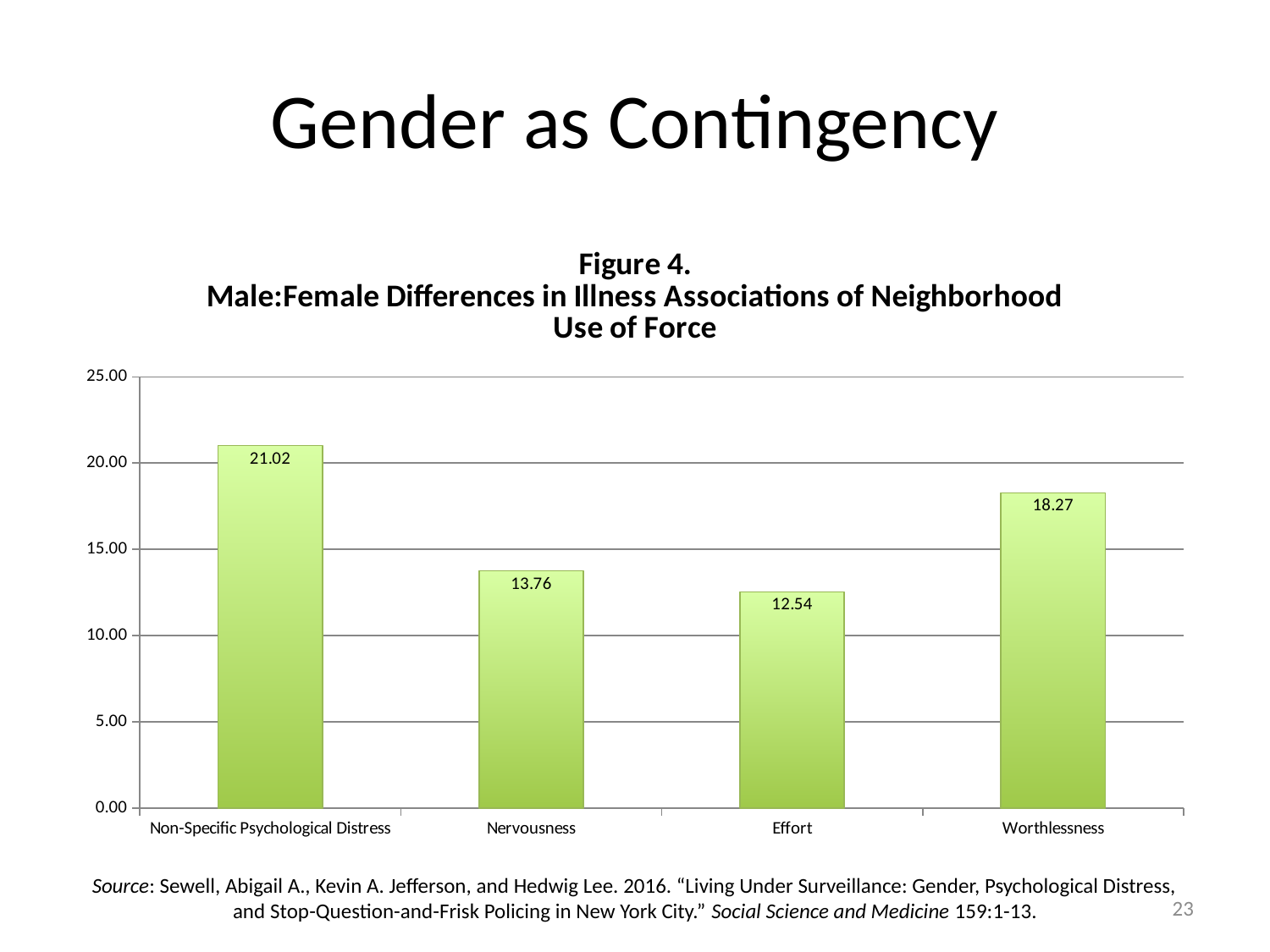
What is the difference between the values for Nervousness and Effort? 1.22 What is the difference between the values for Non-Specific Psychological Distress and Worthlessness? 2.75 How many categories are shown on the x axis? 4 Which is larger, the value for Worthlessness or the value for Nervousness? Worthlessness Is the value for Worthlessness greater or less than 20.00? less Which category has the highest value? Non-Specific Psychological Distress What is the value for Effort? 12.54 What kind of chart is shown on the slide? bar chart Which category has the lowest value? Effort What is the value for Nervousness? 13.76 What is the value for Worthlessness? 18.27 What is the value for Non-Specific Psychological Distress? 21.02